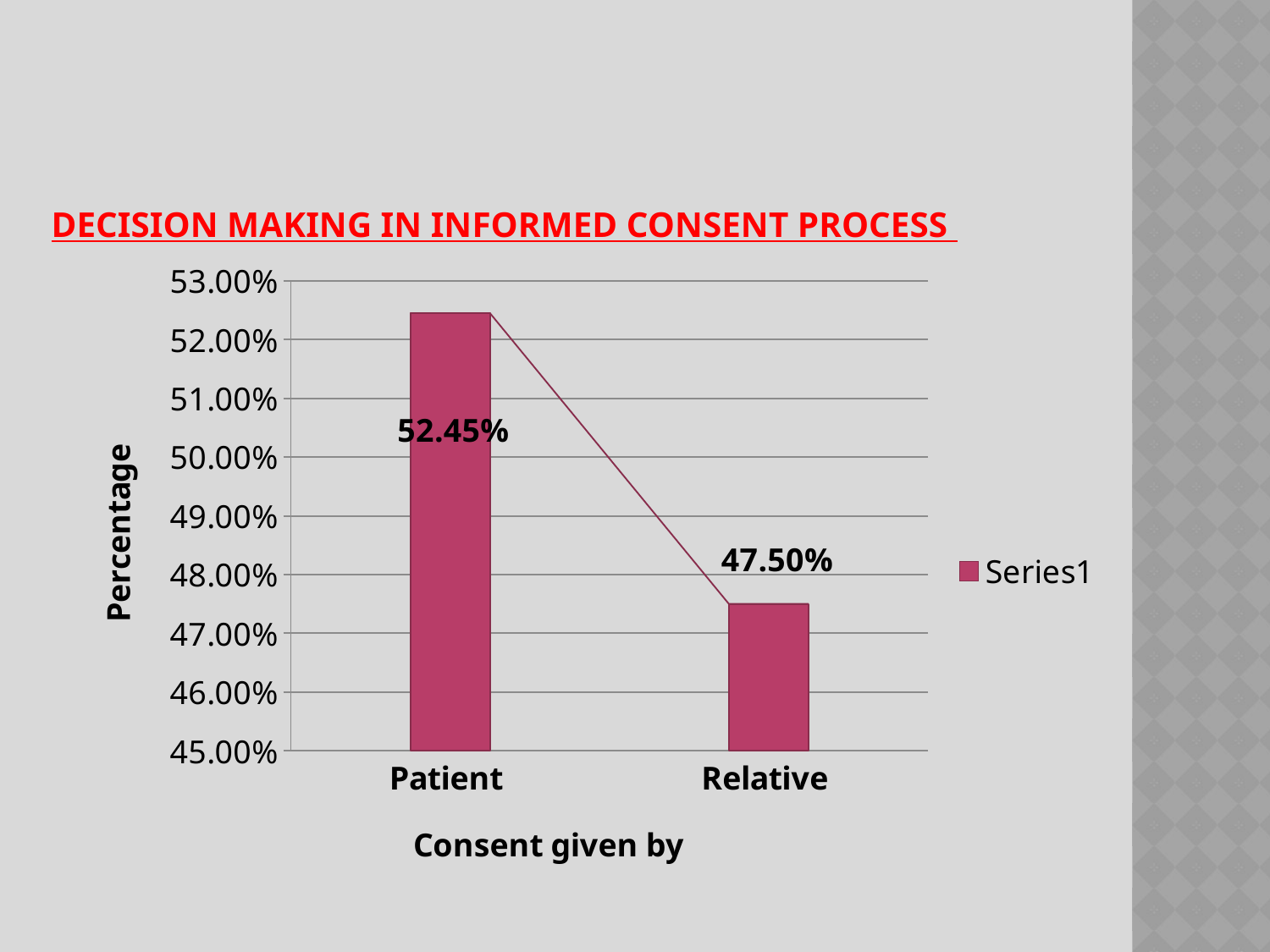
What is the title of the chart? DECISION MAKING IN INFORMED CONSENT PROCESS What kind of chart is shown on the slide? bar chart Which is larger, the value for Patient or the value for Relative? Patient What is the difference between the values for Patient and Relative? 4.95% What is the value for Relative? 47.50% Do the values rise or fall from Patient to Relative? fall How many categories are shown on the x axis? 2 What is the value for Patient? 52.45% Which category has the highest value? Patient Which category has the lowest value? Relative Is the value for Relative greater or less than 48.00%? less How many series does the legend list? 1